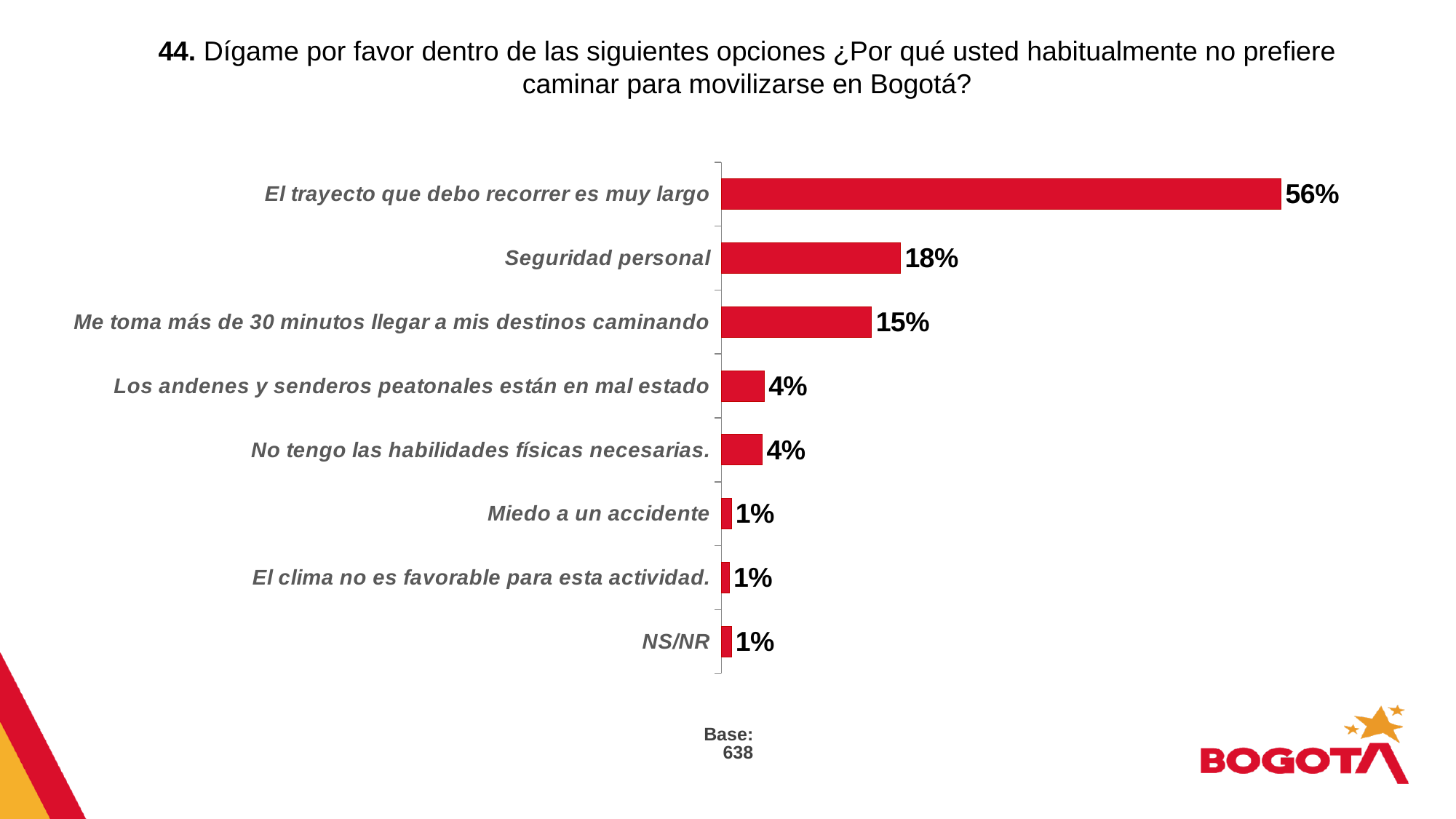
What percentage of respondents chose "El trayecto que debo recorrer es muy largo"? 56% What percentage is shown for "Me toma más de 30 minutos llegar a mis destinos caminando"? 15% What is the difference between "Seguridad personal" and "Me toma más de 30 minutos llegar a mis destinos caminando"? 3% How many categories are shown in the chart? 8 What is the base (number of respondents) shown below the chart? 638 What is the value for "Miedo a un accidente"? 1% What is the difference between the highest value and "Seguridad personal"? 38% What colour are the bars in the chart? Red What is the value shown for "Seguridad personal"? 18% Which is larger, "Seguridad personal" or "Los andenes y senderos peatonales están en mal estado"? Seguridad personal What kind of chart is shown on the slide? Bar chart Which reason has the highest percentage? El trayecto que debo recorrer es muy largo